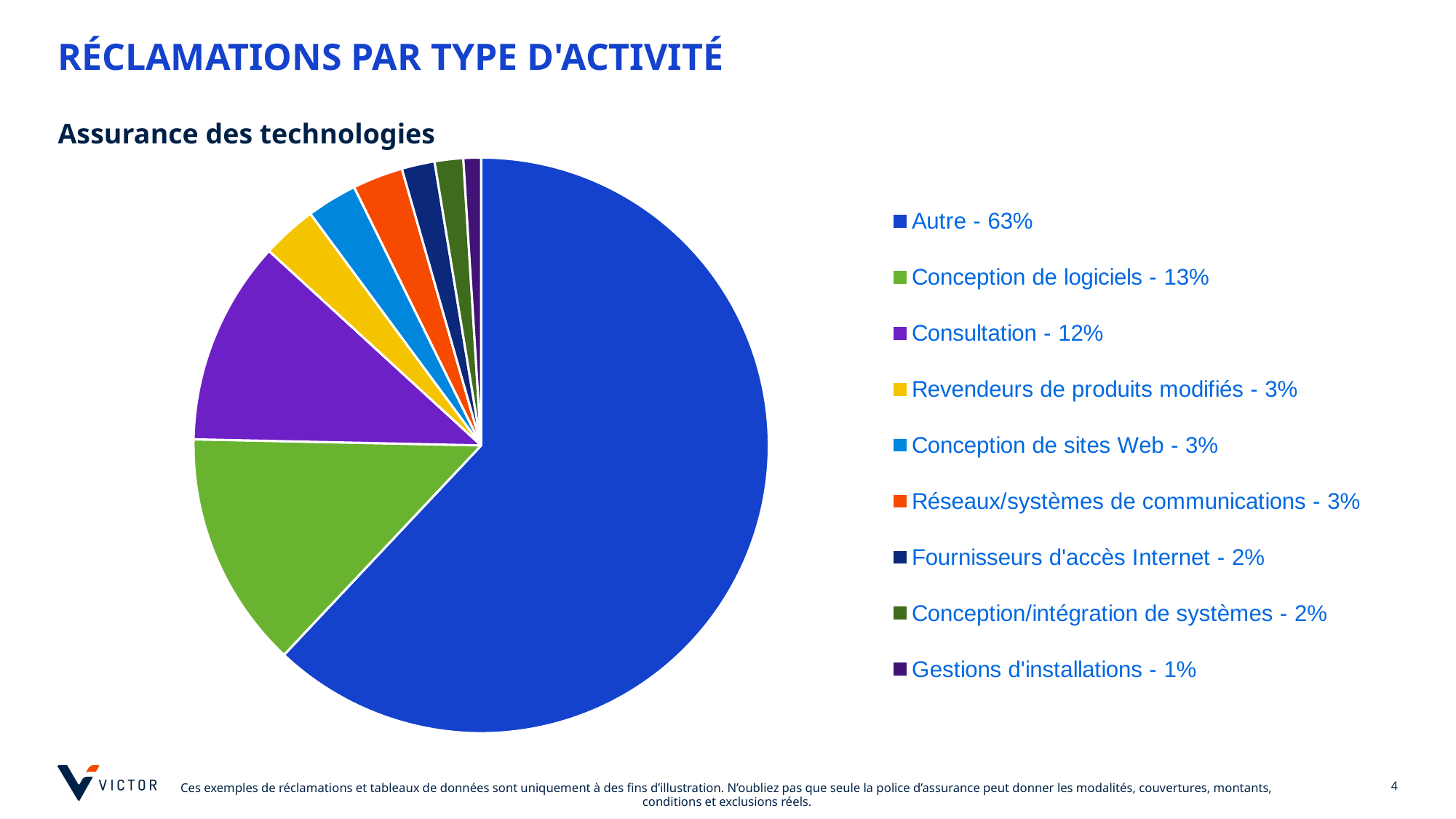
What is the value for 'Gestions d'installations'? 1% Which category has the smallest share of the pie? Gestions d'installations What is the value for 'Conception de logiciels'? 13% What is the difference between the shares of 'Autre' and 'Conception de logiciels'? 50 percentage points What is the value for 'Fournisseurs d'accès Internet'? 2% How many categories does the legend list? 9 What kind of chart is shown on the slide? pie chart What is the subtitle shown above the chart? Assurance des technologies Which is larger, the share for 'Conception de logiciels' or for 'Consultation'? Conception de logiciels Which category has the largest share of the pie? Autre What share of claims does the 'Autre' slice represent? 63% What is the value for 'Consultation'? 12%